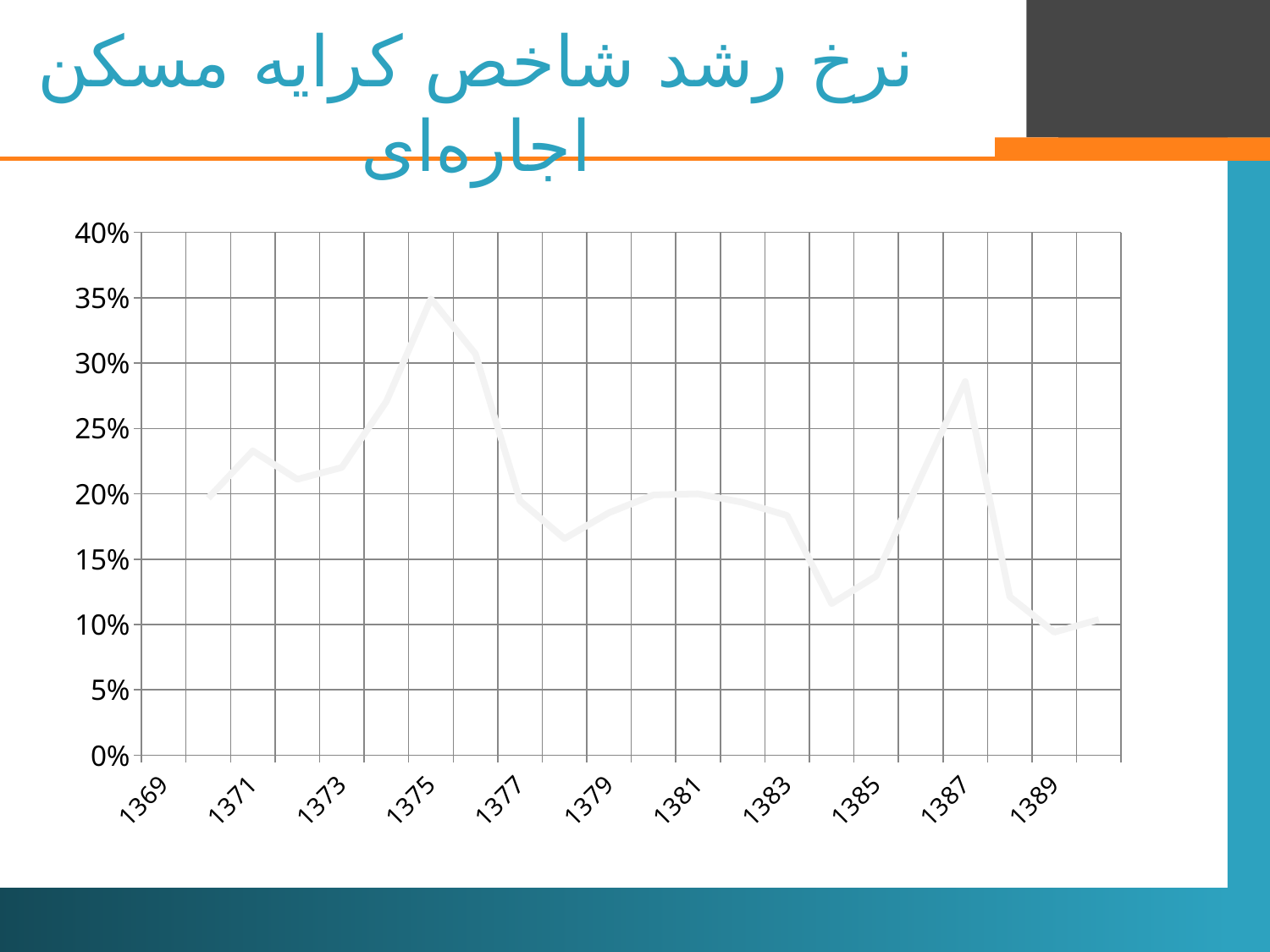
How many year labels are shown on the x axis? 11 Is the value for 1389 greater or less than 15%? less Which year has the larger value, 1375 or 1387? 1375 Is the value for 1387 greater or less than 25%? greater Does the line rise or fall between 1375 and 1379? fall Is the value for 1375 greater or less than 30%? greater Which year has the highest growth rate on the chart? 1375 What kind of chart is shown on the slide? line chart Does the line rise or fall between 1385 and 1387? rise Which year has the larger value, 1377 or 1385? 1377